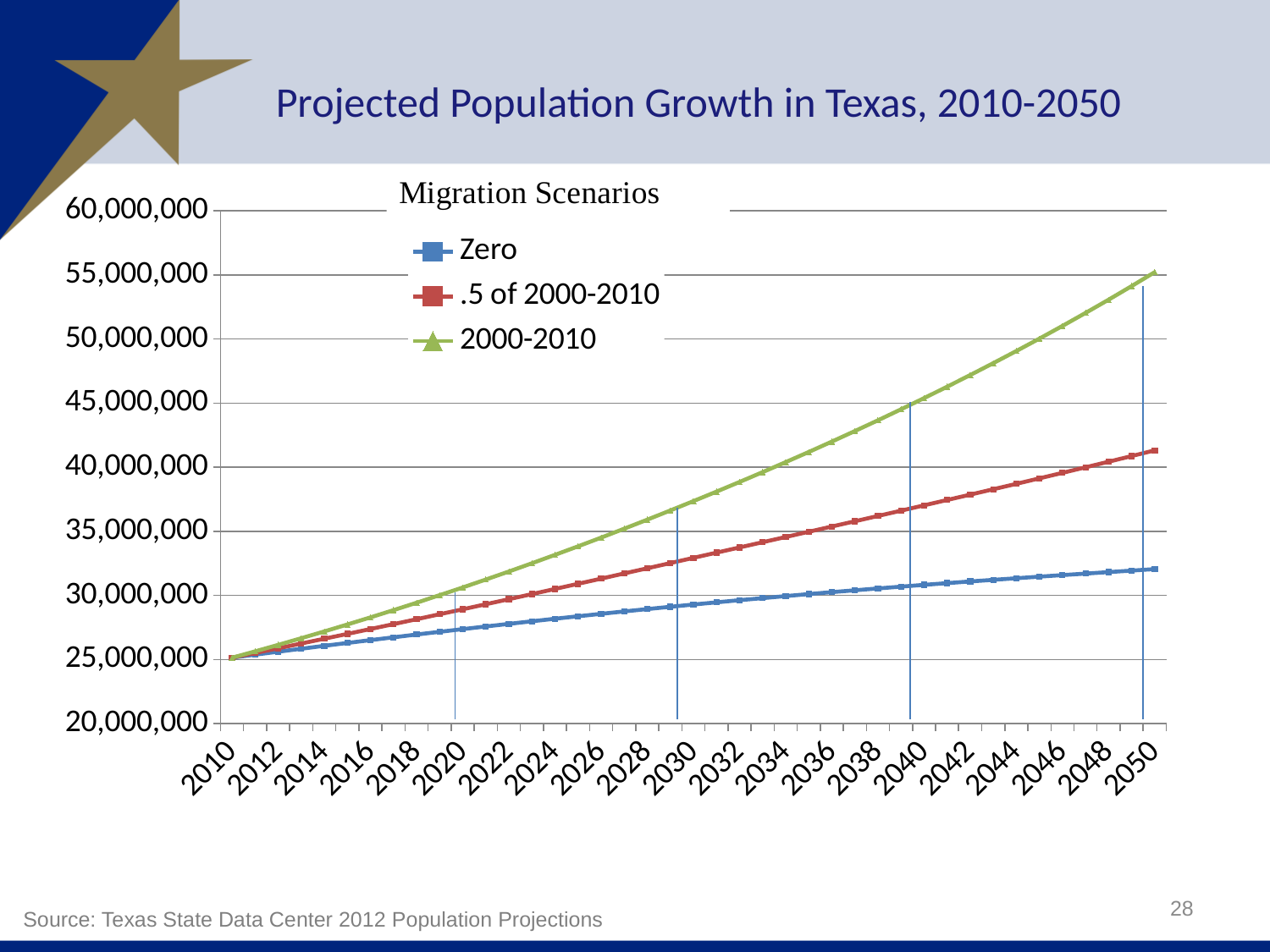
Is the value for the Zero scenario in 2050 greater or less than 35,000,000? less Is the value for the 2000-2010 scenario in 2050 greater or less than 50,000,000? greater Do the values for the 2000-2010 scenario rise or fall from 2010 to 2050? rise What heading appears above the legend entries? Migration Scenarios How many series does the legend list? 3 What is the title of the chart? Projected Population Growth in Texas, 2010-2050 Which migration scenario has the highest projected population in 2050? 2000-2010 What kind of chart is shown on the slide? line chart In 2030, which is larger: the value for the 2000-2010 scenario or the Zero scenario? 2000-2010 Is the value for the .5 of 2000-2010 scenario in 2050 greater or less than 45,000,000? less Which migration scenario has the lowest projected population in 2050? Zero How many year labels are shown on the x axis? 21